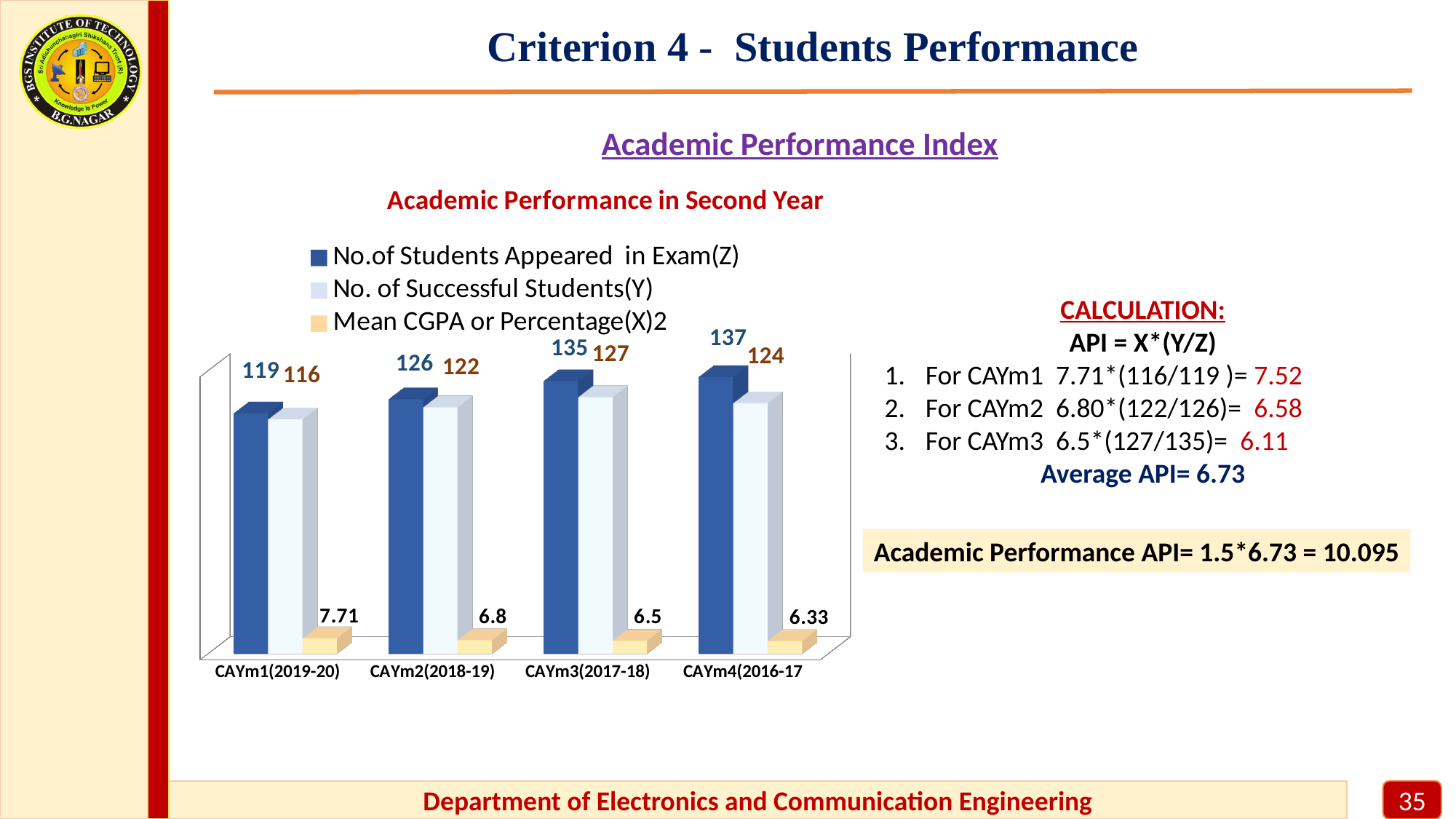
What is the title of the chart? Academic Performance in Second Year What is the Mean CGPA or Percentage (X) value for CAYm2(2018-19)? 6.8 What kind of chart is shown on the slide? Bar chart Which category has the lowest Mean CGPA or Percentage (X) value? CAYm4(2016-17 What is the difference between the number of students appeared in exam and the number of successful students for CAYm4(2016-17)? 13 Does the Mean CGPA or Percentage (X) value rise or fall from CAYm1(2019-20) to CAYm4(2016-17)? Fall Which category has the highest number of students appeared in exam (Z)? CAYm4(2016-17 What is the number of successful students (Y) for CAYm3(2017-18)? 127 How many categories are shown on the x axis of the chart? 4 Which is larger: the number of successful students for CAYm2(2018-19) or for CAYm1(2019-20)? CAYm2(2018-19) What is the number of students appeared in exam (Z) for CAYm1(2019-20)? 119 How many series does the chart legend list? 3